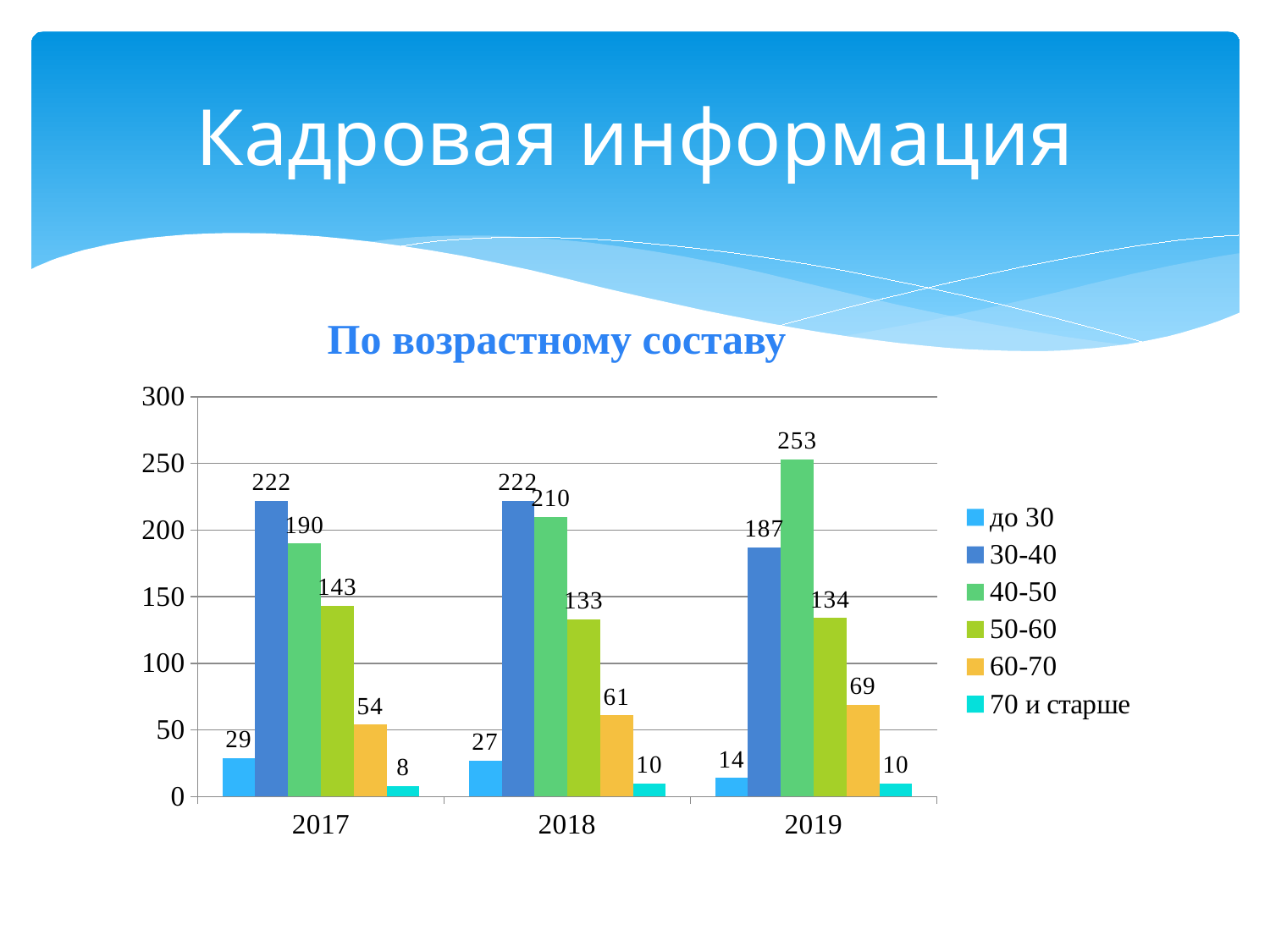
What is the value for the 40-50 series in 2019? 253 Which is larger: the 50-60 value in 2017 or the 50-60 value in 2018? 2017 What is the value for the до 30 series in 2017? 29 Which year has the lowest value for the до 30 series? 2019 Does the value for the до 30 series rise or fall from 2017 to 2019? fall Which year has the highest value for the 40-50 series? 2019 Is the value for the 40-50 series in 2018 greater or less than 200? greater What is the difference between the 30-40 value in 2017 and the 30-40 value in 2019? 35 What kind of chart is shown on the slide? bar chart What is the value for the 60-70 series in 2018? 61 How many years are shown on the x axis? 3 How many series does the legend list? 6